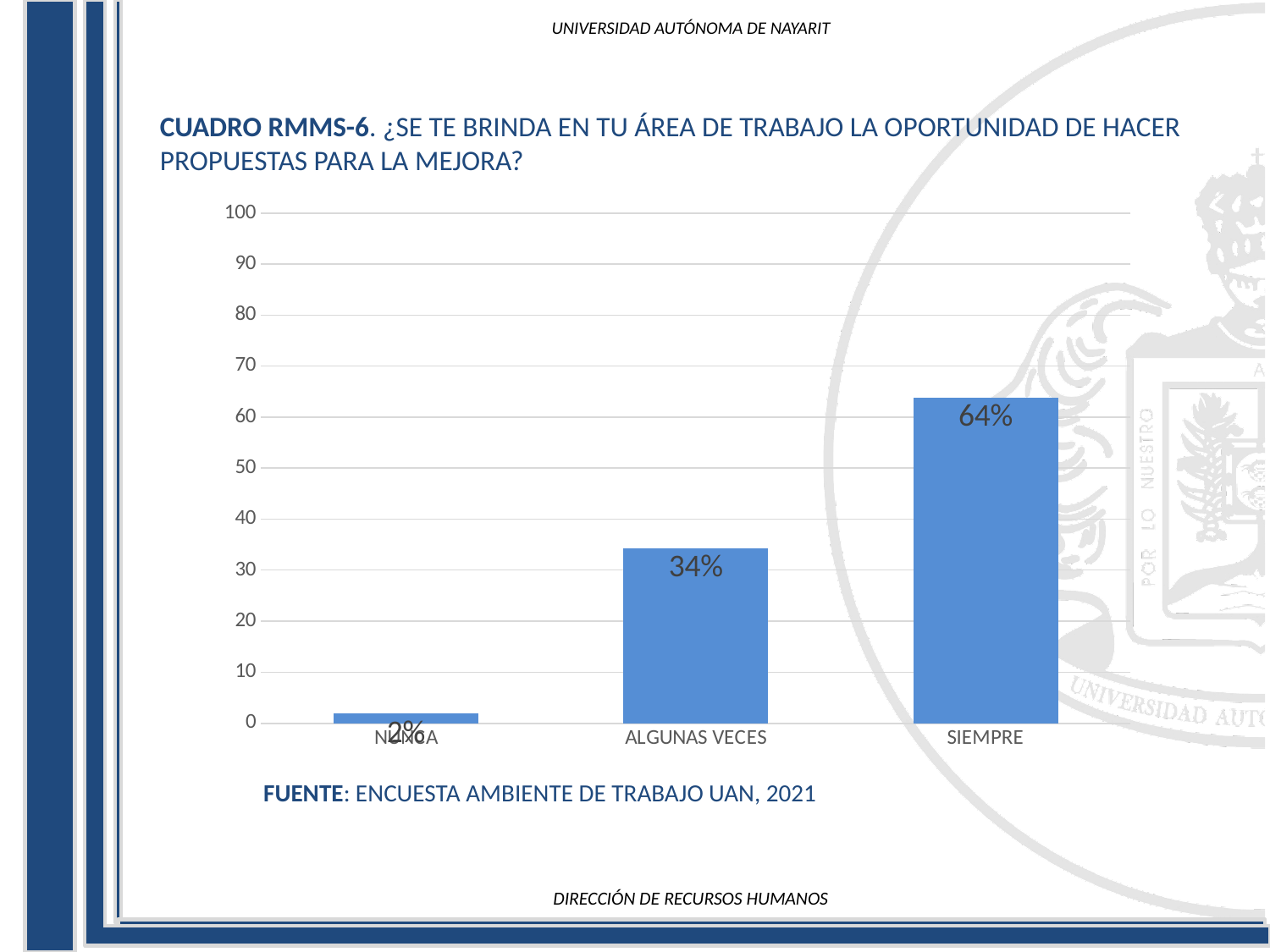
What is the value for NUNCA? 2% Which category has the lowest value? NUNCA What is the difference between the values for ALGUNAS VECES and NUNCA? 32% Which category has the highest value? SIEMPRE Is the value for SIEMPRE greater or less than 50? greater What is the value for SIEMPRE? 64% Which is larger, the value for ALGUNAS VECES or the value for SIEMPRE? SIEMPRE How many categories are shown on the x axis? 3 What is the value for ALGUNAS VECES? 34% What kind of chart is shown on the slide? bar chart What is the difference between the values for SIEMPRE and ALGUNAS VECES? 30% Do the values rise or fall from left to right along the x axis? rise